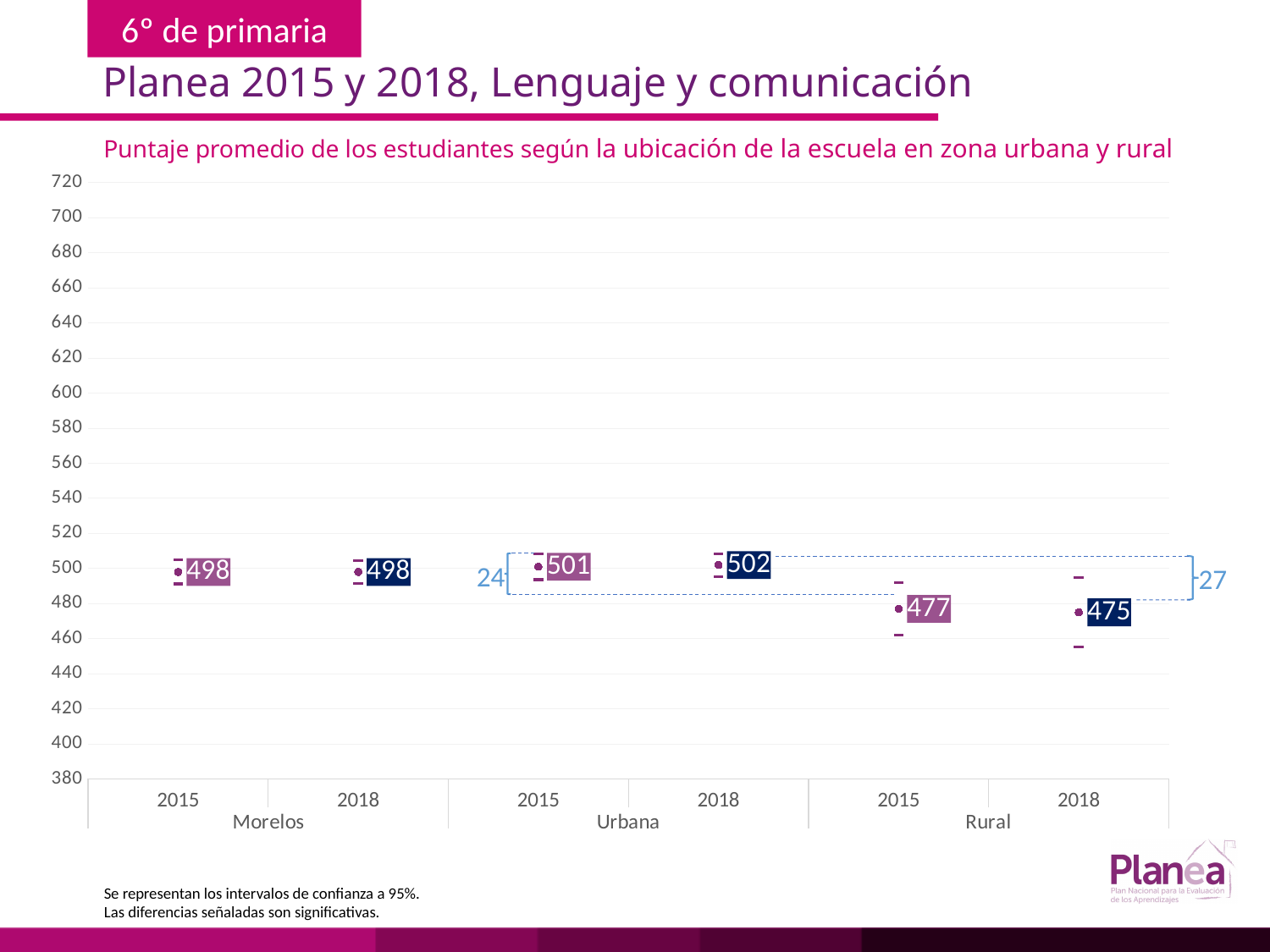
What is the average score for Rural in 2018? 475 What is the difference between the Urbana 2018 score and the Rural 2018 score? 27 What is the average score for Urbana in 2018? 502 What is the subtitle of the chart? Puntaje promedio de los estudiantes según la ubicación de la escuela en zona urbana y rural Which group and year has the lowest average score? Rural 2018 How many data points are plotted on the chart? 6 Is the Rural 2018 score greater or less than 500? less Which is larger, the Urbana 2015 score or the Rural 2015 score? Urbana 2015 What is the difference between the Urbana 2015 score and the Rural 2015 score? 24 Which group and year has the highest average score? Urbana 2018 What is the average score for Rural in 2015? 477 What is the average score for Morelos in 2015? 498